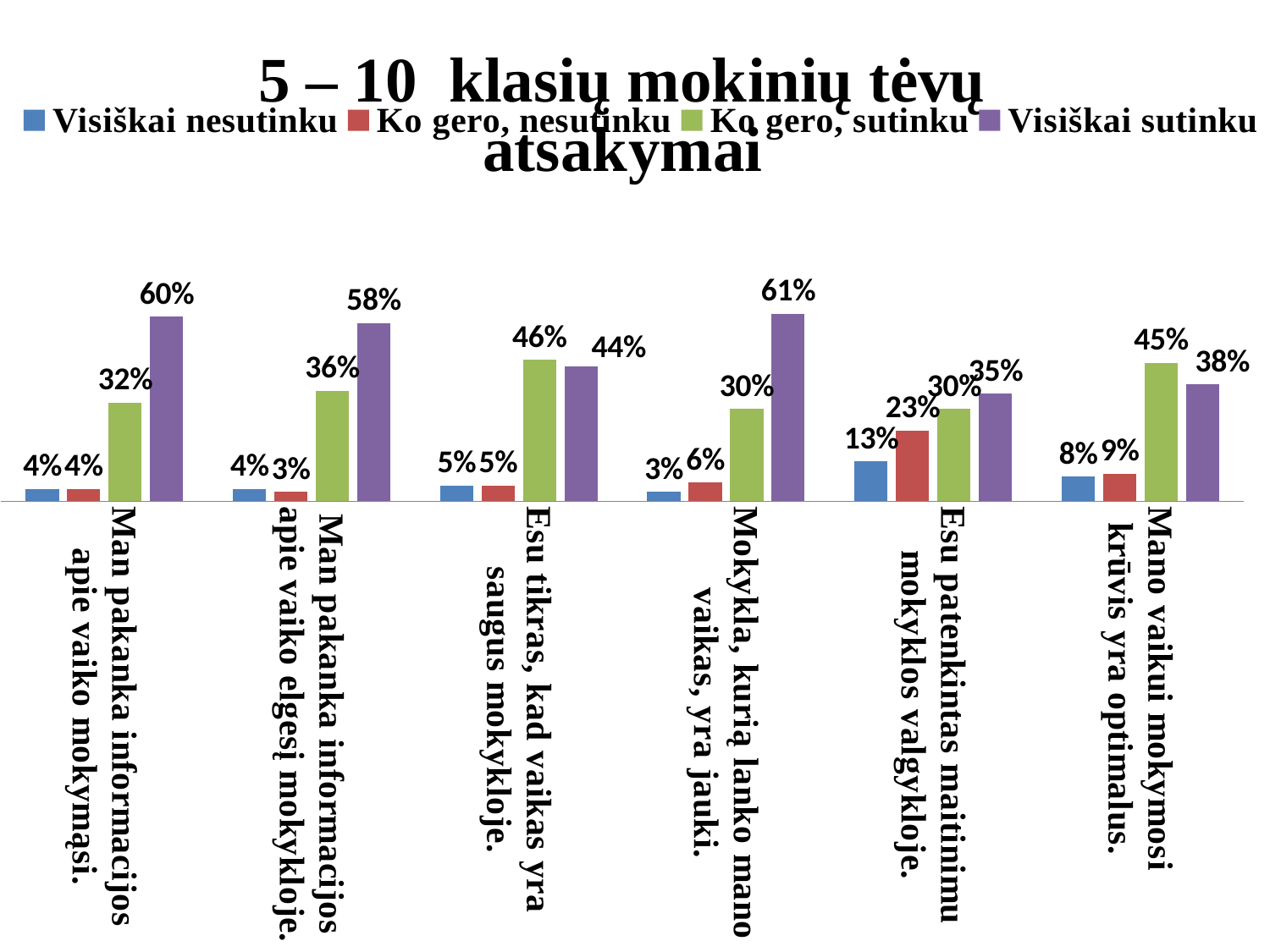
What is the difference between the "Visiškai sutinku" and "Ko gero, sutinku" values for "Man pakanka informacijos apie vaiko elgesį mokykloje"? 22% Which category has the highest "Visiškai sutinku" value? Mokykla, kurią lanko mano vaikas, yra jauki What is the value of "Ko gero, nesutinku" for "Esu patenkintas maitinimu mokyklos valgykloje"? 23% What type of chart is shown on the slide? bar chart What is the value of "Visiškai sutinku" for "Man pakanka informacijos apie vaiko mokymąsi"? 60% What is the value of "Ko gero, sutinku" for "Mano vaikui mokymosi krūvis yra optimalus"? 45% How many categories (statements) are shown on the x axis? 6 Which category has the highest "Visiškai nesutinku" value? Esu patenkintas maitinimu mokyklos valgykloje How many series does the legend list? 4 Which category has the lowest "Visiškai sutinku" value? Esu patenkintas maitinimu mokyklos valgykloje For "Esu tikras, kad vaikas yra saugus mokykloje", which is larger: "Ko gero, sutinku" or "Visiškai sutinku"? Ko gero, sutinku What is the title of the chart? 5 – 10 klasių mokinių tėvų atsakymai